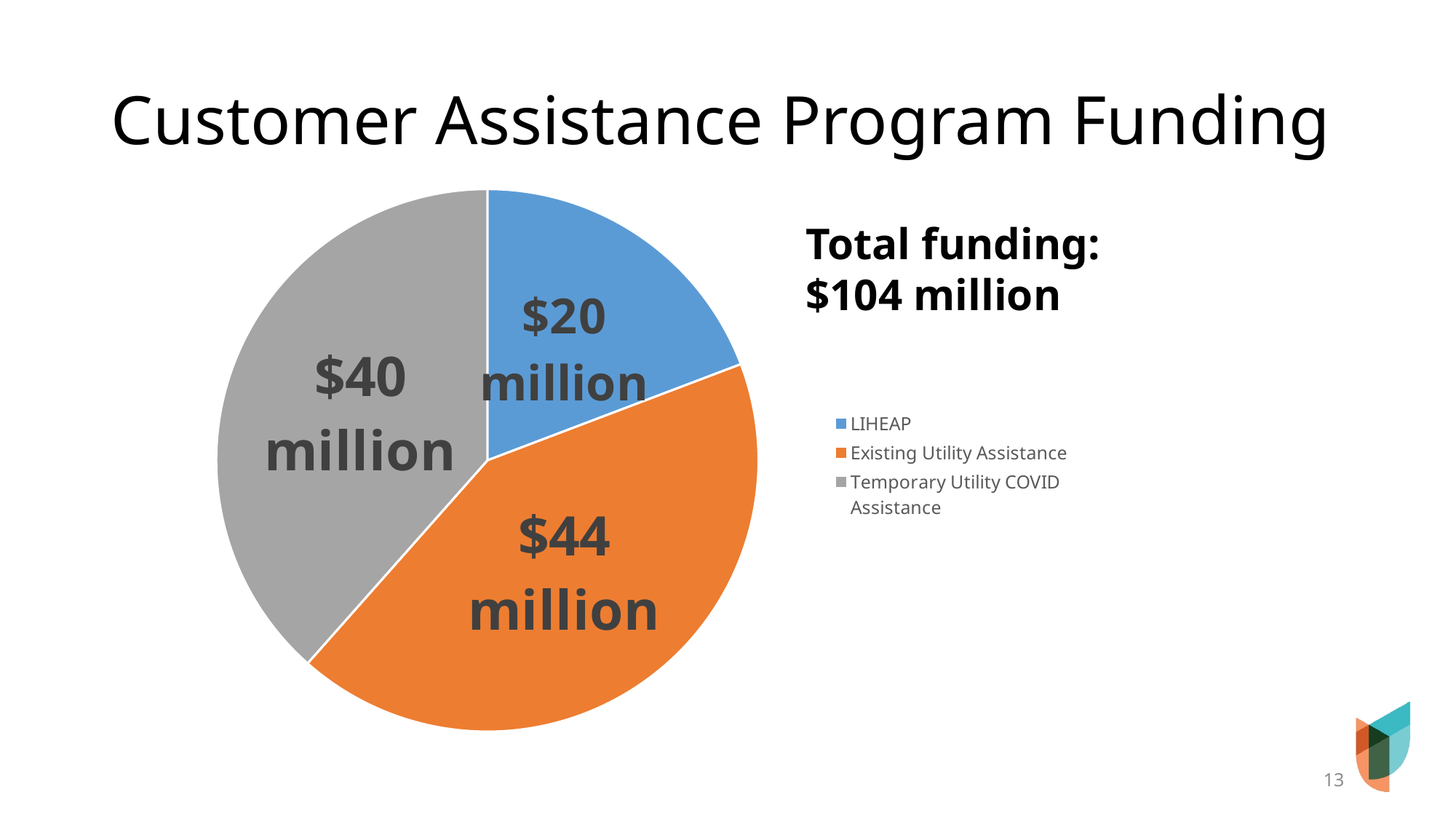
What is the funding amount for Temporary Utility COVID Assistance? $40 million What type of chart is shown on the slide? pie chart What is the total funding shown on the slide? $104 million Which colour represents Existing Utility Assistance in the pie chart? orange How many categories does the pie chart show? 3 What is the difference between the funding for Temporary Utility COVID Assistance and LIHEAP? $20 million What is the funding amount for Existing Utility Assistance? $44 million Which category has the smallest funding amount? LIHEAP What is the funding amount for LIHEAP? $20 million Which category has the largest funding amount? Existing Utility Assistance Which is larger, the funding for Temporary Utility COVID Assistance or for LIHEAP? Temporary Utility COVID Assistance What is the difference between the funding for Existing Utility Assistance and LIHEAP? $24 million